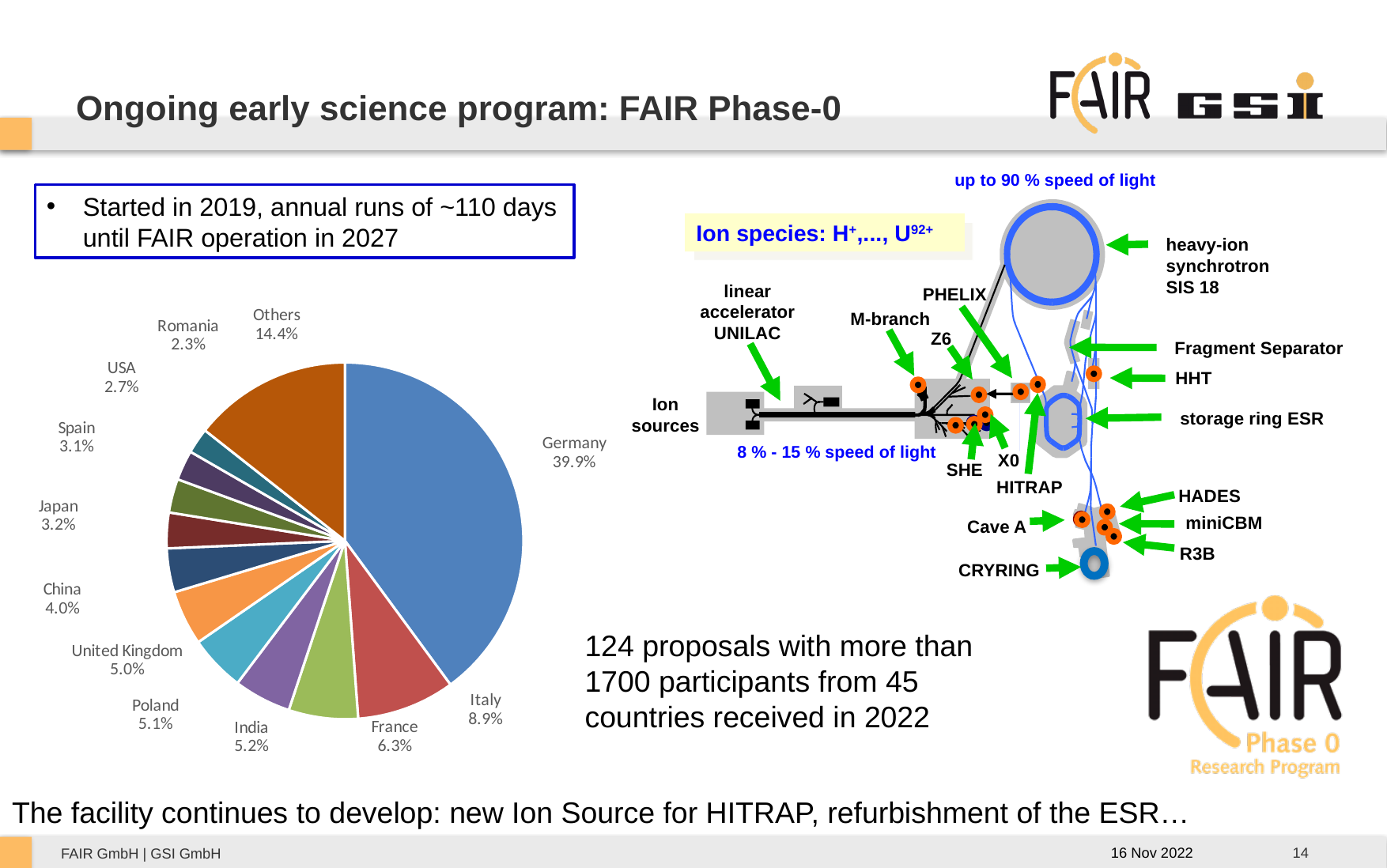
How many slices does the pie chart have? 12 In the pie chart, what share does the United Kingdom have? 5.0% In the pie chart, what share does the 'Others' slice have? 14.4% In the pie chart, what share does Germany have? 39.9% In the pie chart, what share does Italy have? 8.9% In the pie chart, which is larger, the share of France or the share of India? France In the pie chart, what is the difference between the shares of Germany and Italy? 31.0% Which country has the largest slice in the pie chart? Germany What kind of chart is shown on the left of the slide? pie chart In the pie chart, what share does Romania have? 2.3% Which labelled slice in the pie chart is the smallest? Romania In the pie chart, what is the difference between the shares of Poland and China? 1.1%